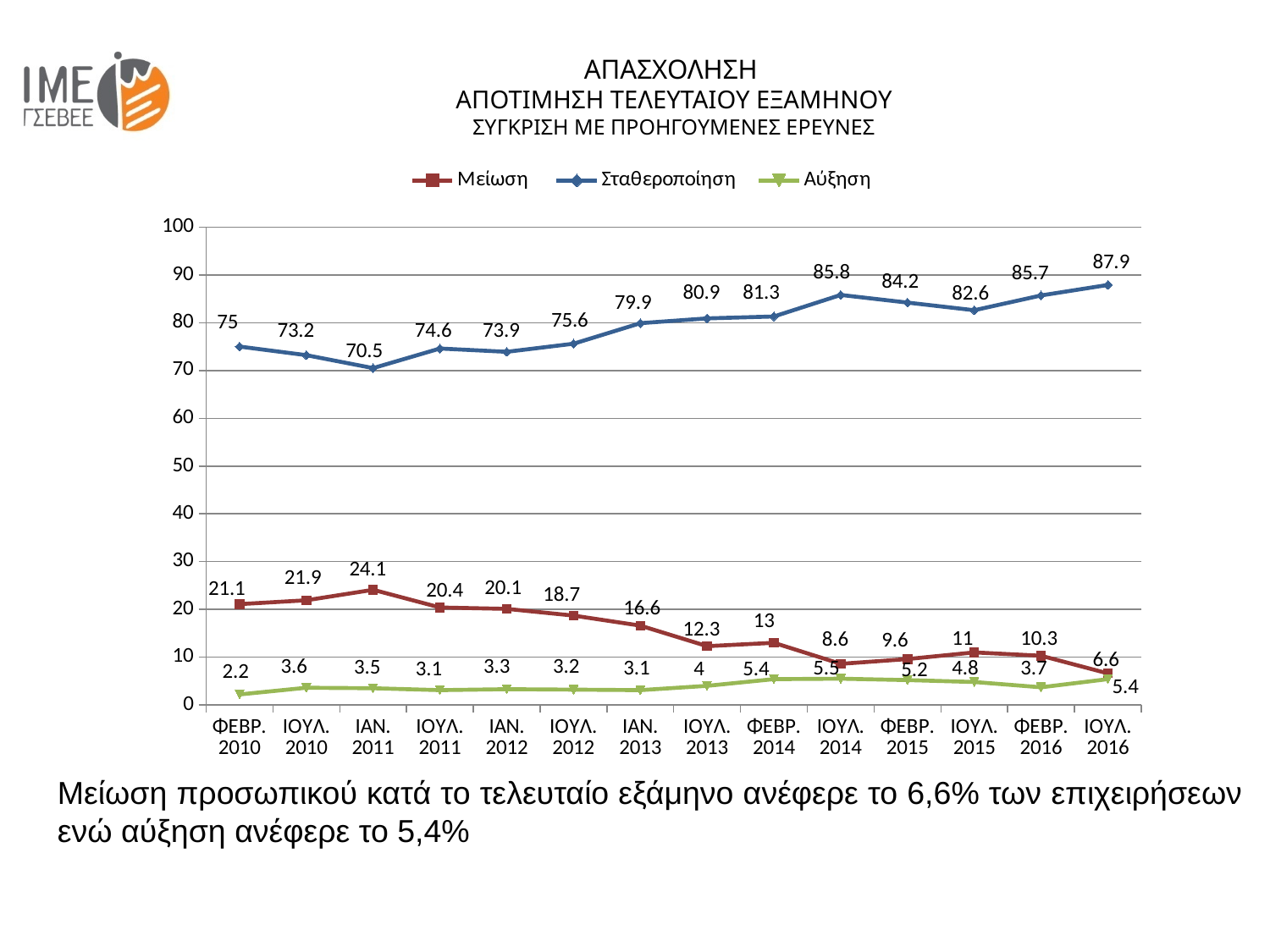
What is the difference between the Μείωση values for ΦΕΒΡ. 2010 and ΙΟΥΛ. 2016? 14.5 How many series does the legend list? 3 In which period does the Σταθεροποίηση series reach its lowest value? ΙΑΝ. 2011 What is the value of Αύξηση for ΦΕΒΡ. 2010? 2.2 Is the Σταθεροποίηση value for ΙΟΥΛ. 2014 greater or less than 80? greater What is the value of Μείωση for ΙΑΝ. 2011? 24.1 Which is larger for ΙΟΥΛ. 2016: the Μείωση value or the Αύξηση value? Μείωση In which period does the Μείωση series reach its highest value? ΙΑΝ. 2011 What kind of chart is shown on the slide? Line chart Does the Μείωση series generally rise or fall from ΦΕΒΡ. 2010 to ΙΟΥΛ. 2016? Fall How many time periods are shown on the x axis? 14 What is the value of Σταθεροποίηση for ΙΟΥΛ. 2016? 87.9